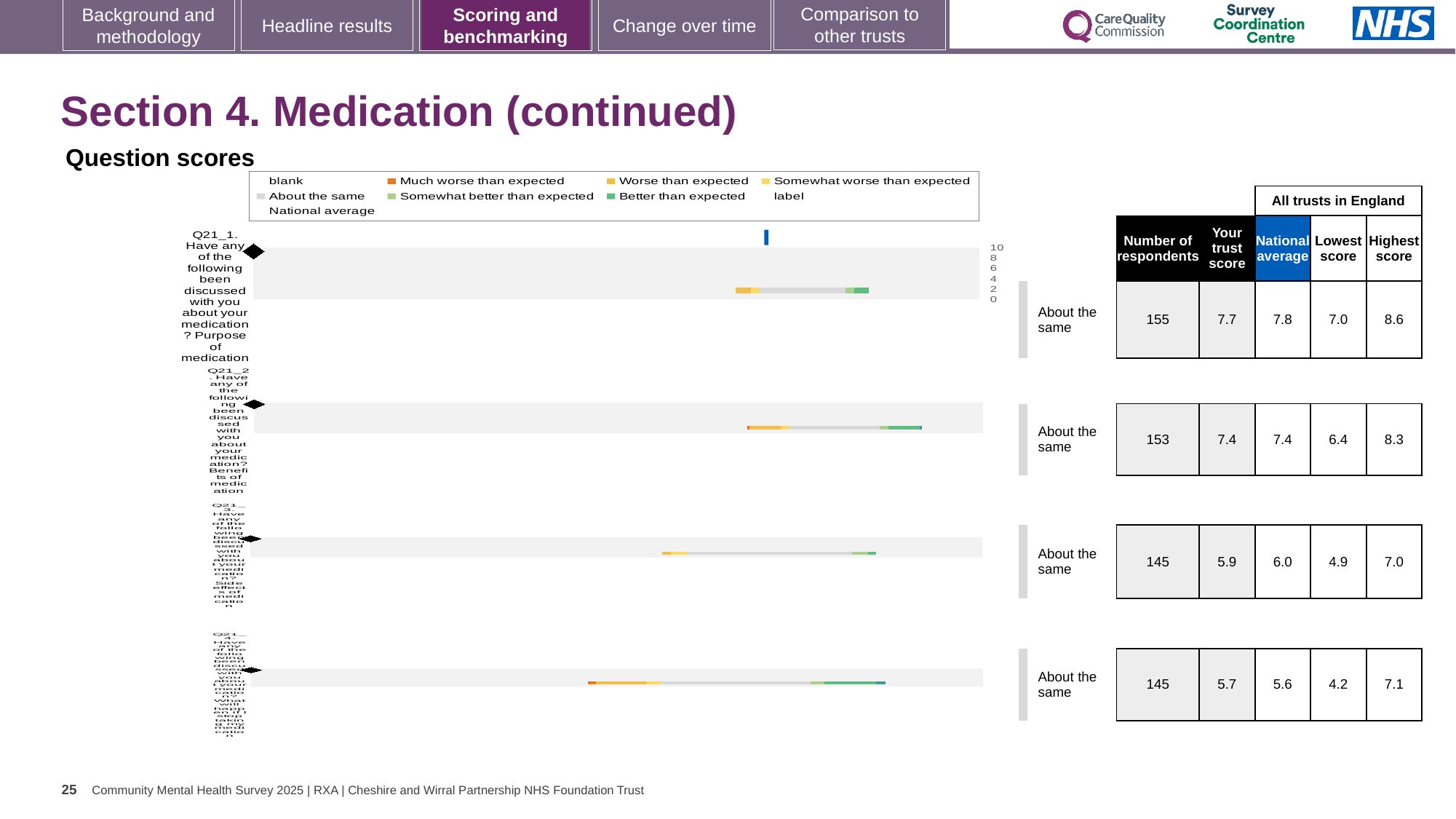
What is the national average for Q21_2 (Benefits of medication)? 7.4 What is the highest score across all trusts in England for Q21_4 (What would happen if stop taking medication)? 7.1 Which question has the lowest trust score? Q21_4 (What would happen if stop taking medication) What is the difference between the highest score and the lowest score for Q21_1 (Purpose of medication)? 1.6 How many questions (bars) are shown in the question scores chart? 4 What is the number of respondents for Q21_1 (Purpose of medication)? 155 What benchmark category is shown next to each of the four question bars? About the same What kind of chart is used to show the question scores on this slide? Bar chart What is the trust score for Q21_1 (Purpose of medication)? 7.7 What is the lowest score across all trusts in England for Q21_3 (Side effects of medication)? 4.9 For Q21_4, which is larger: the trust score or the national average? The trust score (5.7) Which question has the highest trust score? Q21_1 (Purpose of medication)